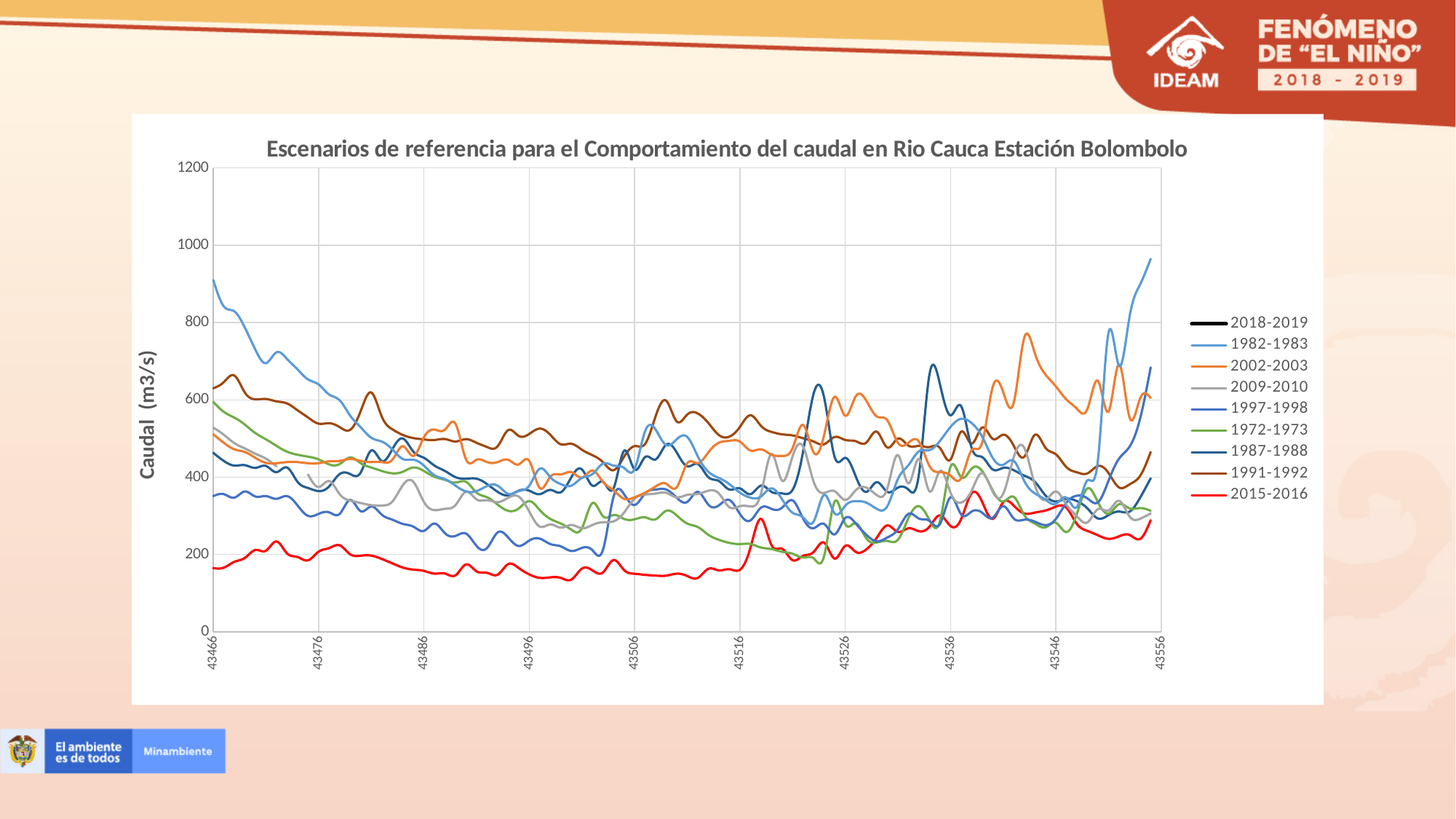
Which series has the highest value at the start of the x axis (43466)? 1982-1983 At 43466, which series has the larger value, 1991-1992 or 1987-1988? 1991-1992 Is the value for 1982-1983 at 43466 greater or less than 800? greater What is the maximum value shown on the vertical axis? 1200 How many series does the legend list? 9 Is the value for 1991-1992 at 43466 greater or less than 500? greater Does the 1982-1983 series rise or fall between 43466 and 43506? fall What is the label of the vertical axis? Caudal (m3/s) Is the value for 2015-2016 at 43466 greater or less than 200? less What kind of chart is shown on the slide? line chart What is the title of the chart? Escenarios de referencia para el Comportamiento del caudal en Rio Cauca Estación Bolombolo Which series has the lowest value at the start of the x axis (43466)? 2015-2016